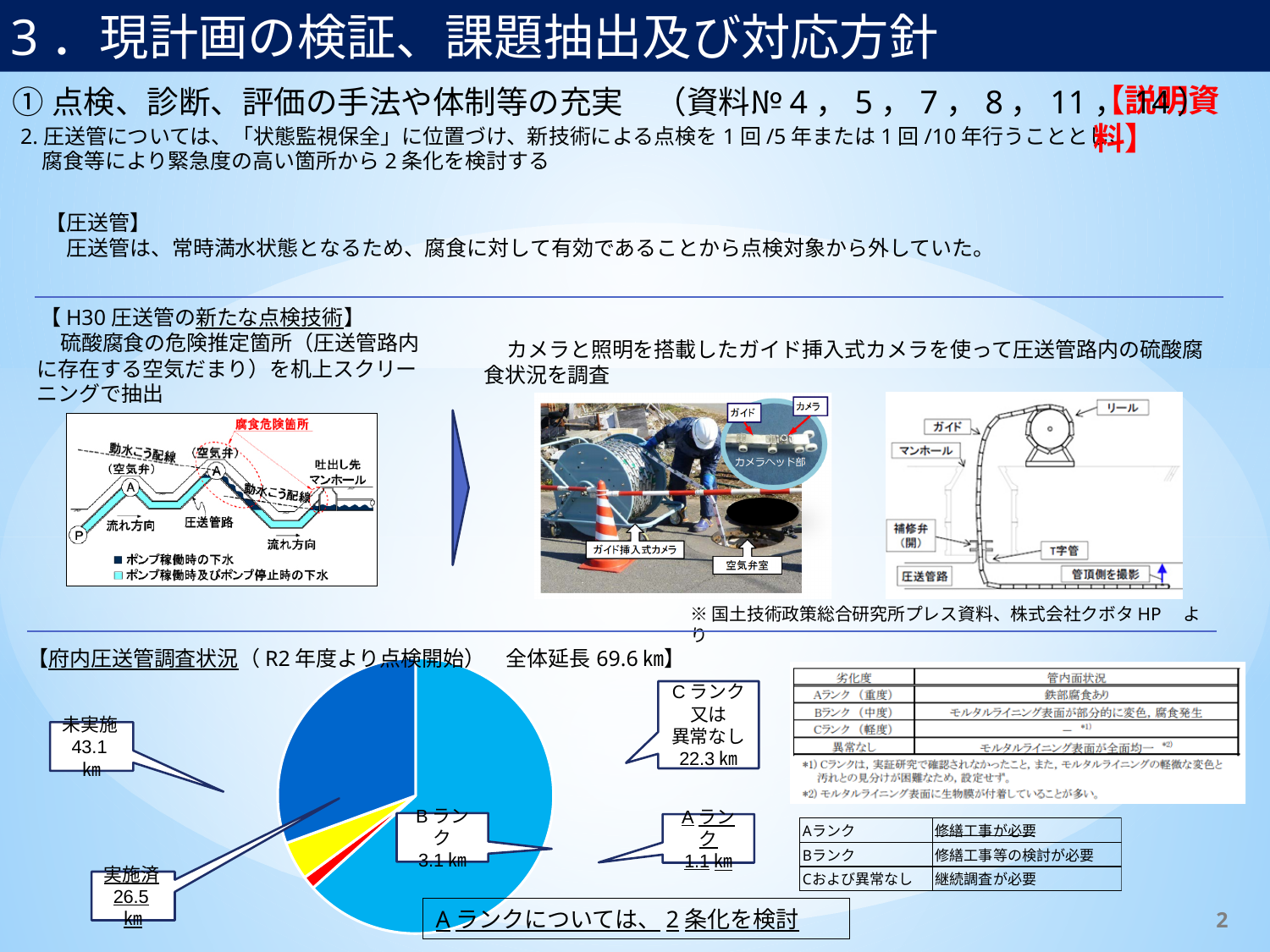
In the pie chart, what is the value labelled 実施済? 26.5 km What total length (全体延長) is stated in the heading of the pie chart? 69.6 km In the pie chart, what is the value for Aランク? 1.1 km How many slices does the pie chart have? 4 Which slice of the pie chart is the smallest? Aランク In the pie chart, which is larger, Bランク or Aランク? Bランク Which slice of the pie chart is the largest? 未実施 In the pie chart, what is the value for Cランク又は異常なし? 22.3 km In the pie chart, what is the difference between 未実施 and Cランク又は異常なし? 20.8 km What kind of chart is shown at the bottom of the slide under 府内圧送管調査状況? pie chart In the pie chart, what is the value for 未実施? 43.1 km In the pie chart, what is the value for Bランク? 3.1 km